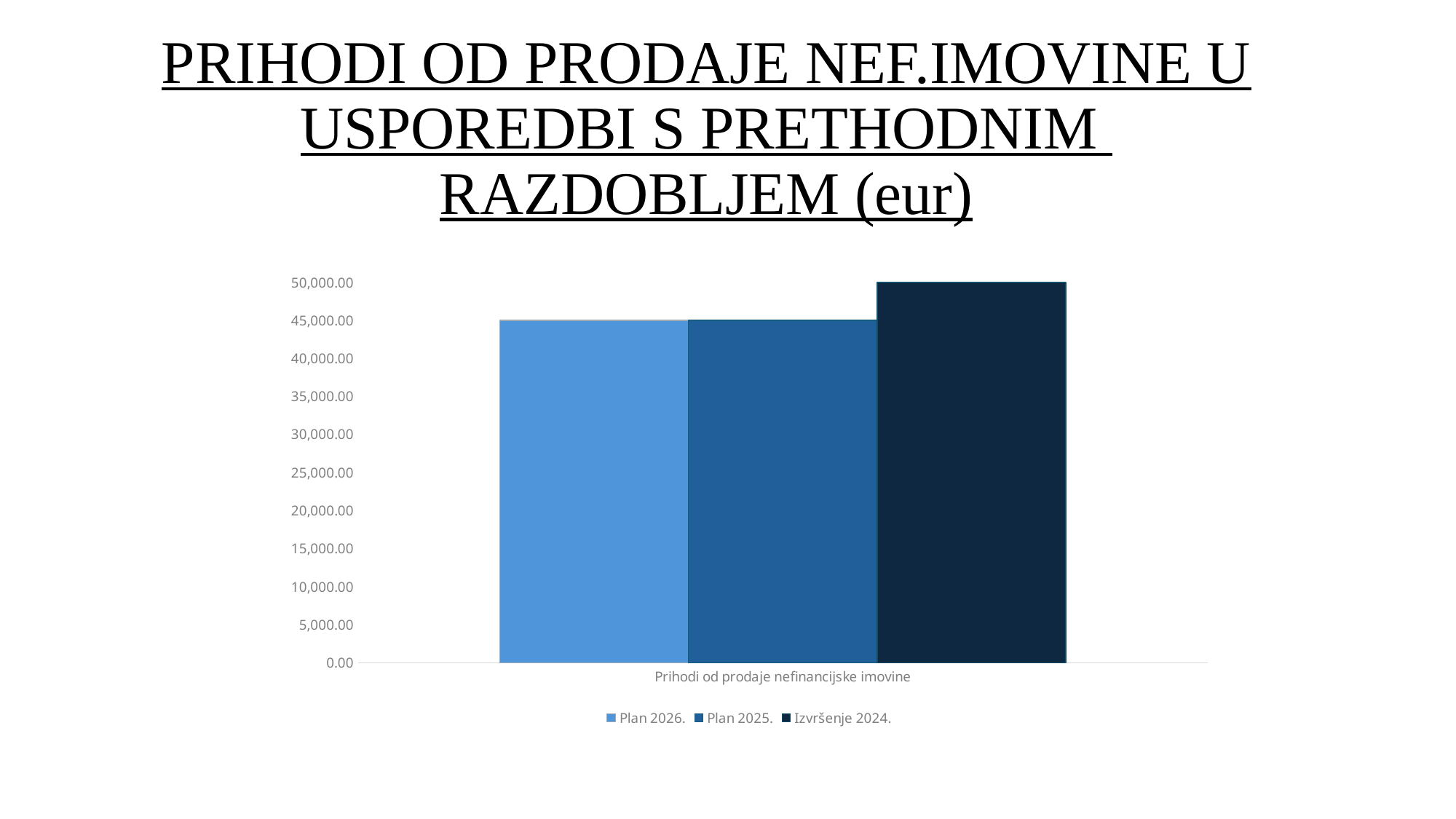
What kind of chart is shown on the slide? bar chart How many series does the legend list? 3 Is the value for Plan 2025. greater or less than 50,000.00? less Which series has the highest value for Prihodi od prodaje nefinancijske imovine? Izvršenje 2024. Which is larger, the value for Plan 2025. or the value for Izvršenje 2024.? Izvršenje 2024. Which series is shown with the darkest bar? Izvršenje 2024. Which is larger, the value for Plan 2026. or the value for Izvršenje 2024.? Izvršenje 2024. Is the value for Izvršenje 2024. greater or less than 45,000.00? greater Is the value for Plan 2026. greater or less than 40,000.00? greater What is the category label shown on the x axis? Prihodi od prodaje nefinancijske imovine How many categories are shown on the x axis? 1